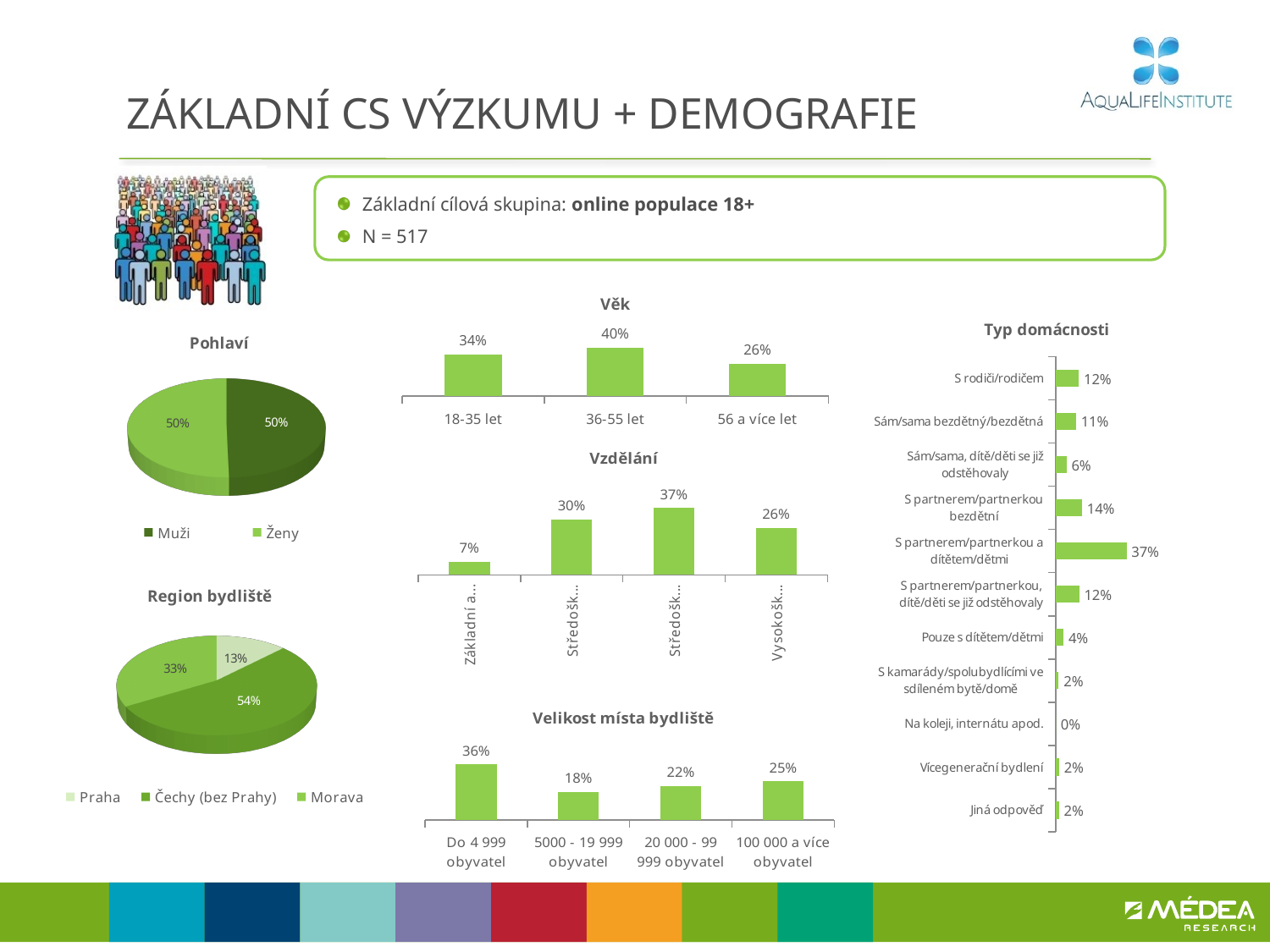
In the 'Věk' chart, what is the value for 36-55 let? 40% In the 'Vzdělání' chart, what is the highest value shown? 37% In the 'Region bydliště' pie chart, what share does Praha have? 13% In the 'Typ domácnosti' chart, which category has the lowest value? Na koleji, internátu apod. In the 'Velikost místa bydliště' chart, which is larger: 5000 - 19 999 obyvatel or 20 000 - 99 999 obyvatel? 20 000 - 99 999 obyvatel How many categories does the 'Typ domácnosti' chart show? 11 In the 'Věk' chart, which age group has the lowest value? 56 a více let What type of chart is the 'Pohlaví' chart? Pie chart In the 'Velikost místa bydliště' chart, which category has the highest value? Do 4 999 obyvatel In the 'Velikost místa bydliště' chart, what is the value for 100 000 a více obyvatel? 25% In the 'Věk' chart, what is the difference between 18-35 let and 56 a více let? 8 percentage points In the 'Typ domácnosti' chart, what is the value for S partnerem/partnerkou a dítětem/dětmi? 37%